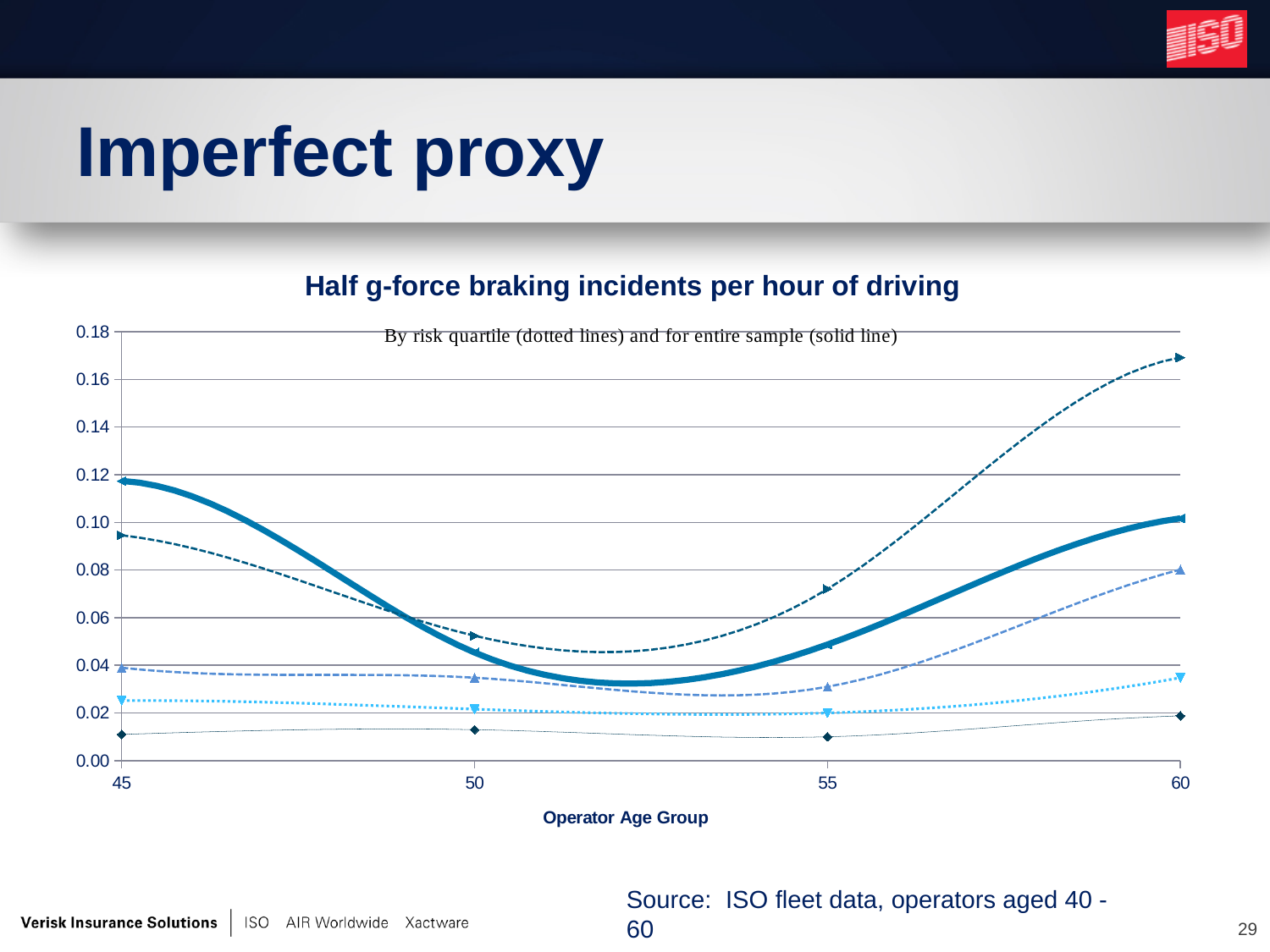
Is the value of the lowest line at age group 45 greater or less than 0.02? less How many operator age groups are shown on the x axis? 4 Is the value of the solid line (entire sample) at age group 45 greater or less than 0.10? greater What is the title of the chart? Half g-force braking incidents per hour of driving What is the label of the x axis? Operator Age Group Is the value of the solid line (entire sample) at age group 60 greater or less than 0.08? greater What kind of chart is shown on the slide? line chart How many lines are plotted on the chart? 5 Does the solid line (entire sample) rise or fall from age group 45 to age group 50? fall Does the solid line (entire sample) rise or fall from age group 55 to age group 60? rise